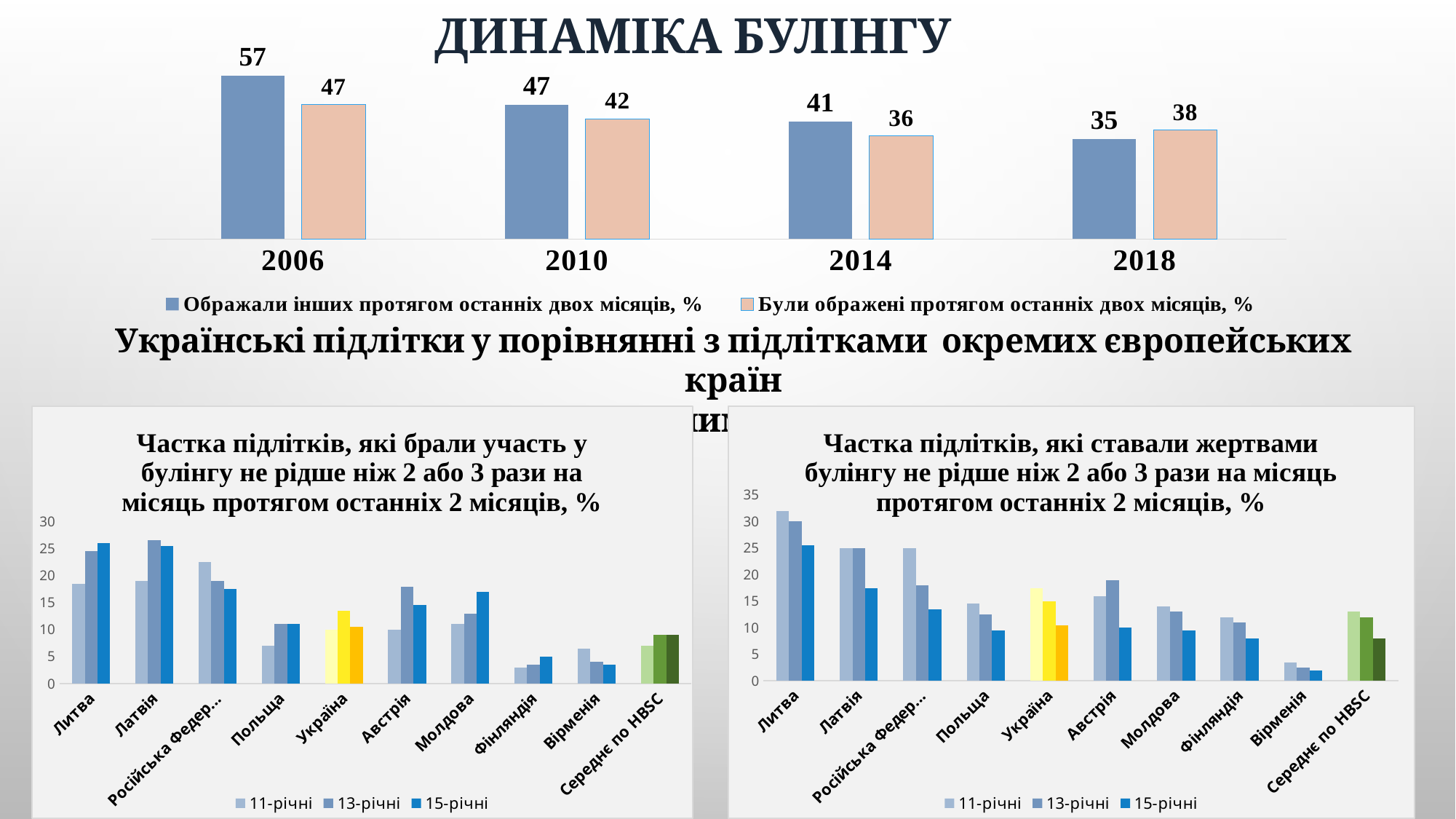
In the bottom-left chart, is the value for 15-річні in Фінляндія greater or less than 10? less How many series does the legend of the bottom-left chart list? 3 In the top chart 'ДИНАМІКА БУЛІНГУ', in 2018 which series has the larger value? Були ображені протягом останніх двох місяців, % In the top chart 'ДИНАМІКА БУЛІНГУ', what is the difference between the two series' values in 2014? 5 What kind of chart is the bottom-left chart? bar chart In the top chart 'ДИНАМІКА БУЛІНГУ', does the value for 'Ображали інших протягом останніх двох місяців, %' rise or fall from 2006 to 2018? fall In the top chart 'ДИНАМІКА БУЛІНГУ', what is the value for 'Ображали інших протягом останніх двох місяців, %' in 2006? 57 In the top chart 'ДИНАМІКА БУЛІНГУ', which year has the lowest value for 'Ображали інших протягом останніх двох місяців, %'? 2018 How many years are shown on the x axis of the top chart 'ДИНАМІКА БУЛІНГУ'? 4 How many countries/categories are shown on the x axis of the bottom-right chart? 10 In the bottom-right chart, is the value for 11-річні in Литва greater or less than 30? greater In the top chart 'ДИНАМІКА БУЛІНГУ', what is the value for 'Були ображені протягом останніх двох місяців, %' in 2018? 38